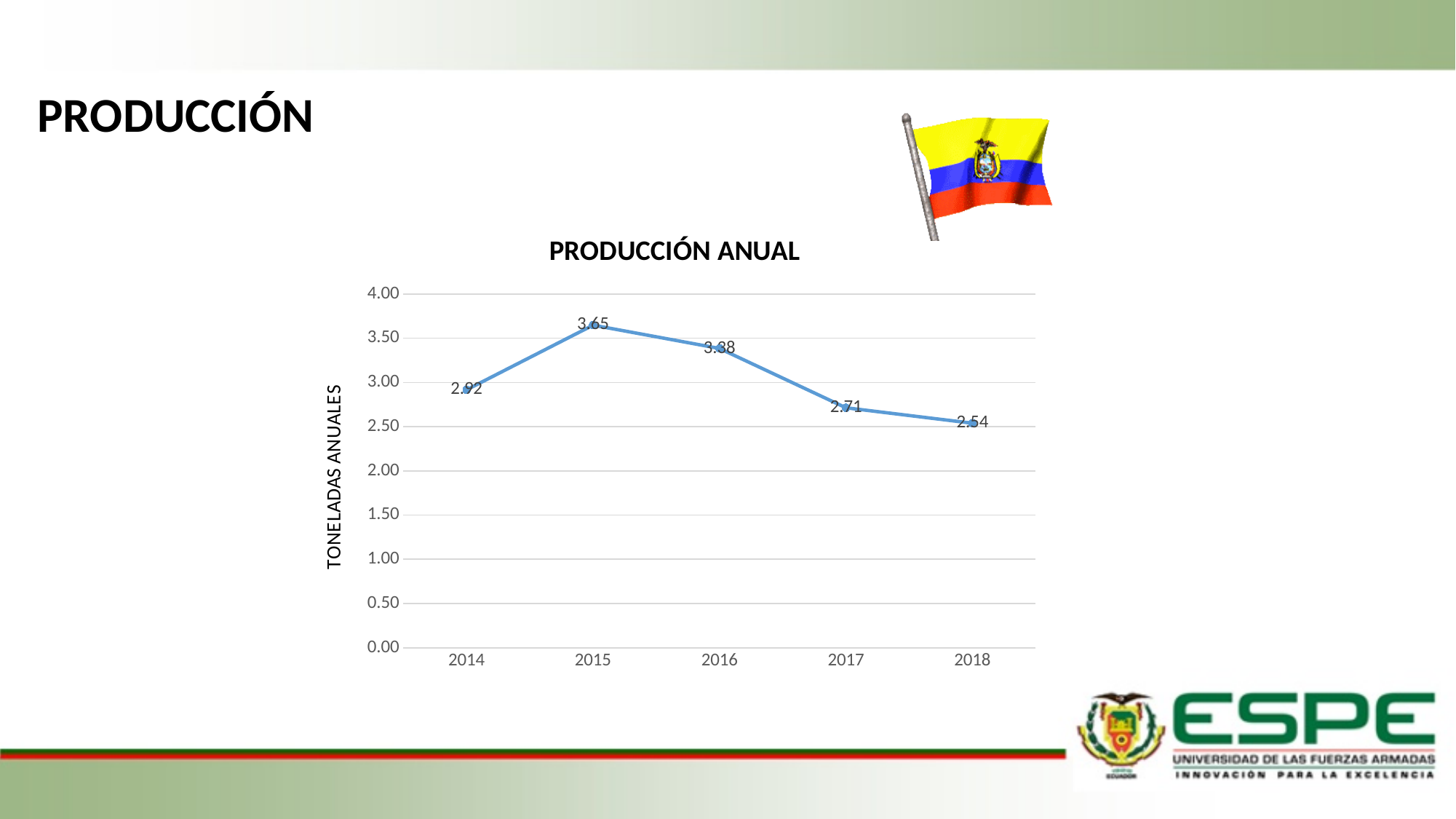
What kind of chart is shown? line chart What is the production value for 2014? 2.92 What is the title of the chart? PRODUCCIÓN ANUAL Which is larger, the value for 2014 or the value for 2017? 2014 How many years are plotted on the chart? 5 Do the values rise or fall from 2015 to 2018? fall Which year has the lowest production? 2018 What is the production value for 2018? 2.54 What is the production value for 2015? 3.65 Which year has the highest production? 2015 What is the difference between the 2015 and 2016 values? 0.27 Is the value for 2016 greater or less than 3.00? greater